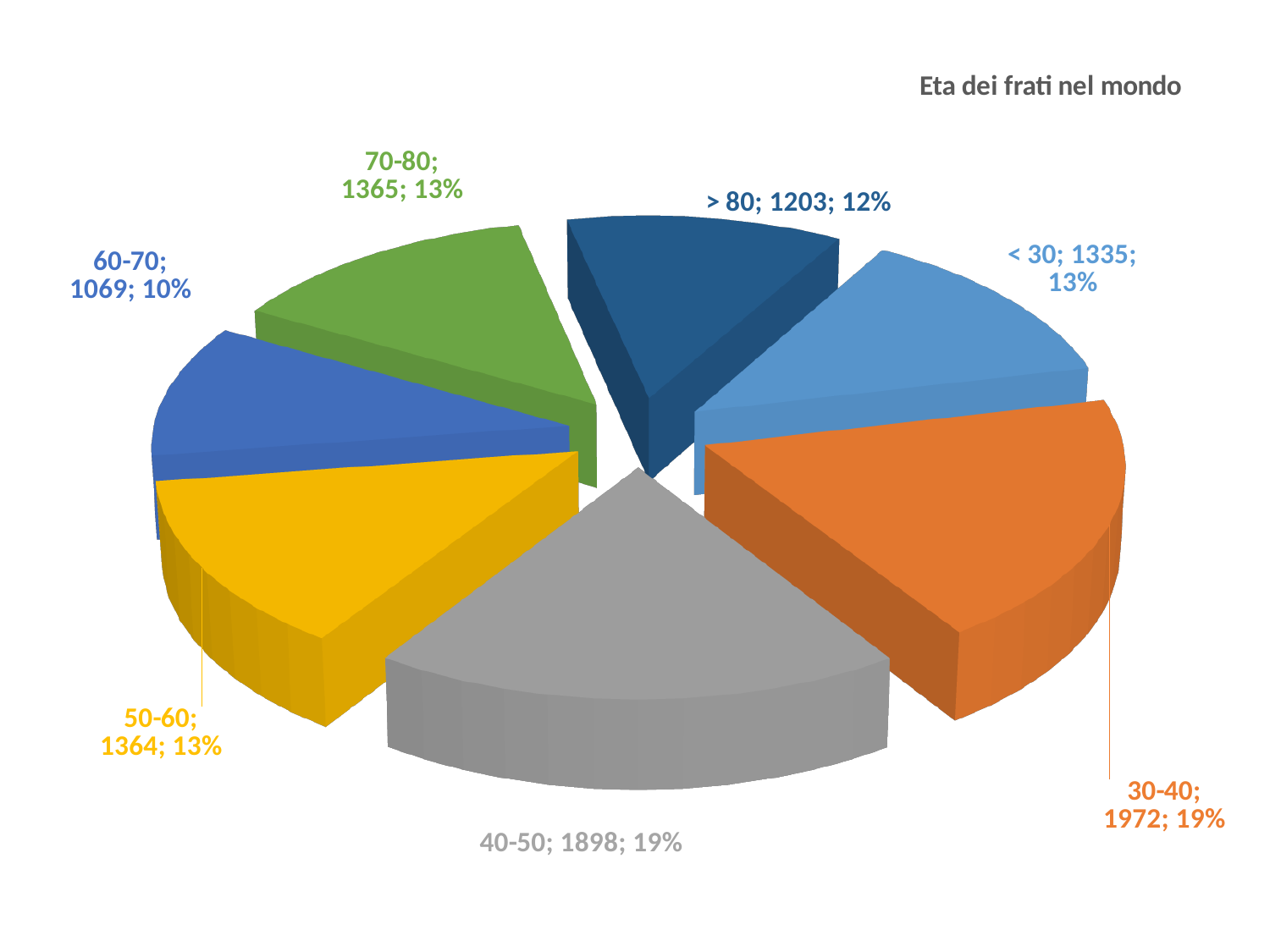
Which is larger, the value for < 30 or the value for > 80? < 30 What is the title of the chart? Eta dei frati nel mondo Which category has the smallest value? 60-70 What is the value for the 60-70 category? 1069 What is the difference between the values for 30-40 and 40-50? 74 What is the value for the > 80 category? 1203 What kind of chart is shown on the slide? pie chart What share of the pie does the 40-50 slice represent? 19% Which category has the largest value? 30-40 What share of the pie does the 60-70 slice represent? 10% What is the value for the 30-40 category? 1972 How many slices does the pie chart have? 7